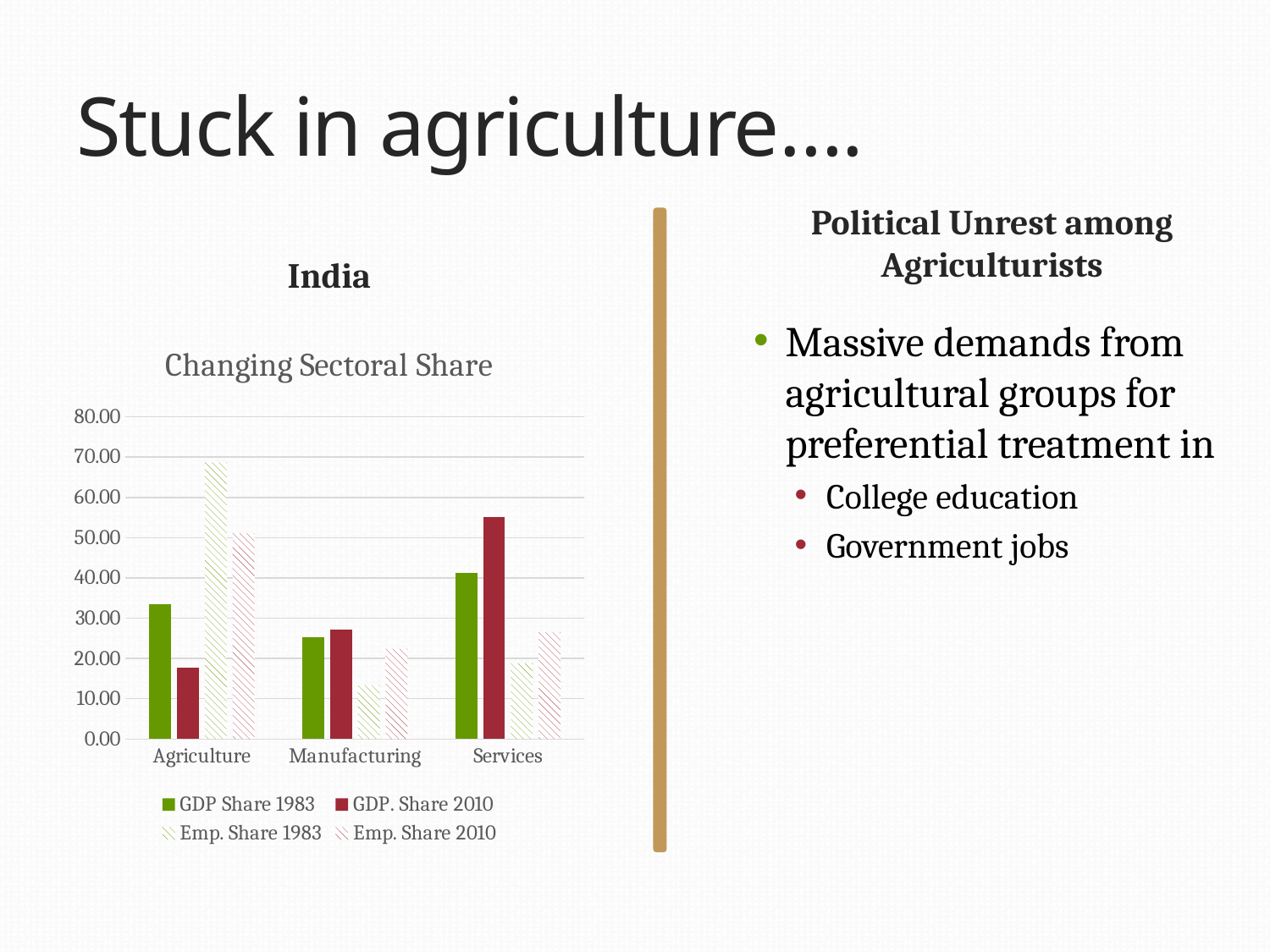
Is the value for GDP. Share 2010 in Services greater or less than 50.00? greater Does the Emp. Share 2010 value rise or fall from Agriculture to Manufacturing? fall Which is larger in Services: GDP Share 1983 or GDP. Share 2010? GDP. Share 2010 How many categories are shown on the x axis of the "Changing Sectoral Share" chart? 3 What kind of chart is shown under the title "Changing Sectoral Share"? bar chart Which category has the lowest GDP. Share 2010 value? Agriculture How many series does the legend of the "Changing Sectoral Share" chart list? 4 Is the value for Emp. Share 1983 in Agriculture greater or less than 60.00? greater What is the title of the chart on the slide? Changing Sectoral Share Is the value for GDP. Share 2010 in Agriculture greater or less than 20.00? less Which category has the highest Emp. Share 1983 value? Agriculture